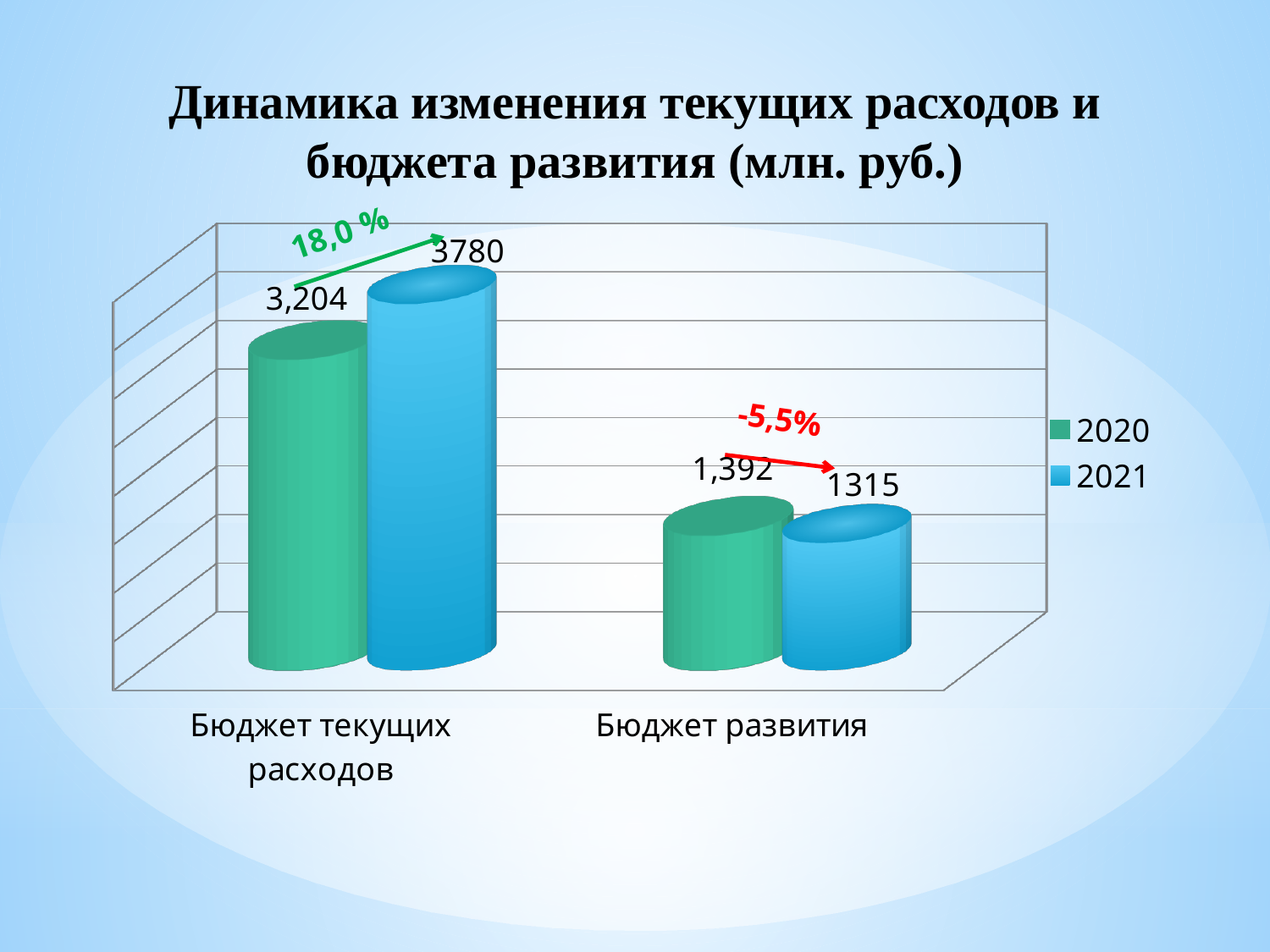
How many series does the legend list? 2 What is the difference between the 2021 and 2020 values for Бюджет текущих расходов? 576 What is the value for 2020 for Бюджет развития? 1,392 What is the value for 2021 for Бюджет развития? 1315 What percentage change is annotated above the Бюджет развития bars? -5,5% What is the difference between the 2020 and 2021 values for Бюджет развития? 77 What is the value for 2020 for Бюджет текущих расходов? 3,204 What is the value for 2021 for Бюджет текущих расходов? 3780 Which bar is the highest on the chart? Бюджет текущих расходов, 2021 How many categories are shown on the x axis? 2 Which bar is the lowest on the chart? Бюджет развития, 2021 Which is larger for Бюджет развития: the 2020 value or the 2021 value? 2020